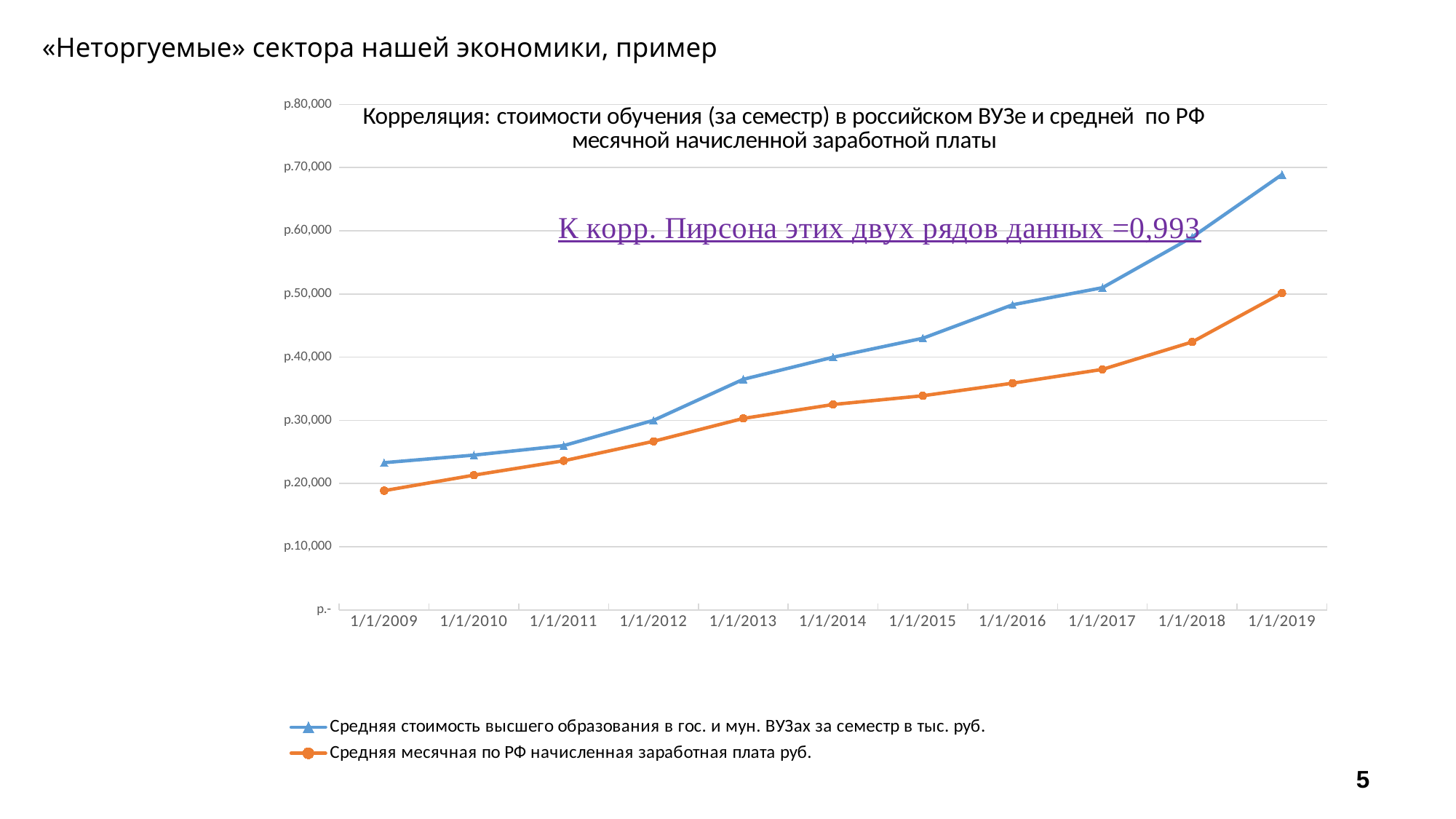
At which date is the series 'Средняя месячная по РФ начисленная заработная плата руб.' lowest? 1/1/2009 How many dates are shown on the x axis? 11 What kind of chart is shown on the slide? line chart At 1/1/2019, which series has the larger value: 'Средняя стоимость высшего образования в гос. и мун. ВУЗах за семестр в тыс. руб.' or 'Средняя месячная по РФ начисленная заработная плата руб.'? Средняя стоимость высшего образования в гос. и мун. ВУЗах за семестр в тыс. руб. At which date is the series 'Средняя стоимость высшего образования в гос. и мун. ВУЗах за семестр в тыс. руб.' highest? 1/1/2019 Is the value for 'Средняя стоимость высшего образования в гос. и мун. ВУЗах за семестр в тыс. руб.' at 1/1/2019 greater or less than р.60,000? greater Do the values of the series 'Средняя месячная по РФ начисленная заработная плата руб.' rise or fall along the x axis? rise Is the value for 'Средняя стоимость высшего образования в гос. и мун. ВУЗах за семестр в тыс. руб.' at 1/1/2009 greater or less than р.30,000? less Is the value for 'Средняя месячная по РФ начисленная заработная плата руб.' at 1/1/2016 greater or less than р.30,000? greater What Pearson correlation coefficient between the two data series is stated on the chart? 0,993 How many series does the legend list? 2 Do the values of the series 'Средняя стоимость высшего образования в гос. и мун. ВУЗах за семестр в тыс. руб.' rise or fall from 1/1/2009 to 1/1/2019? rise